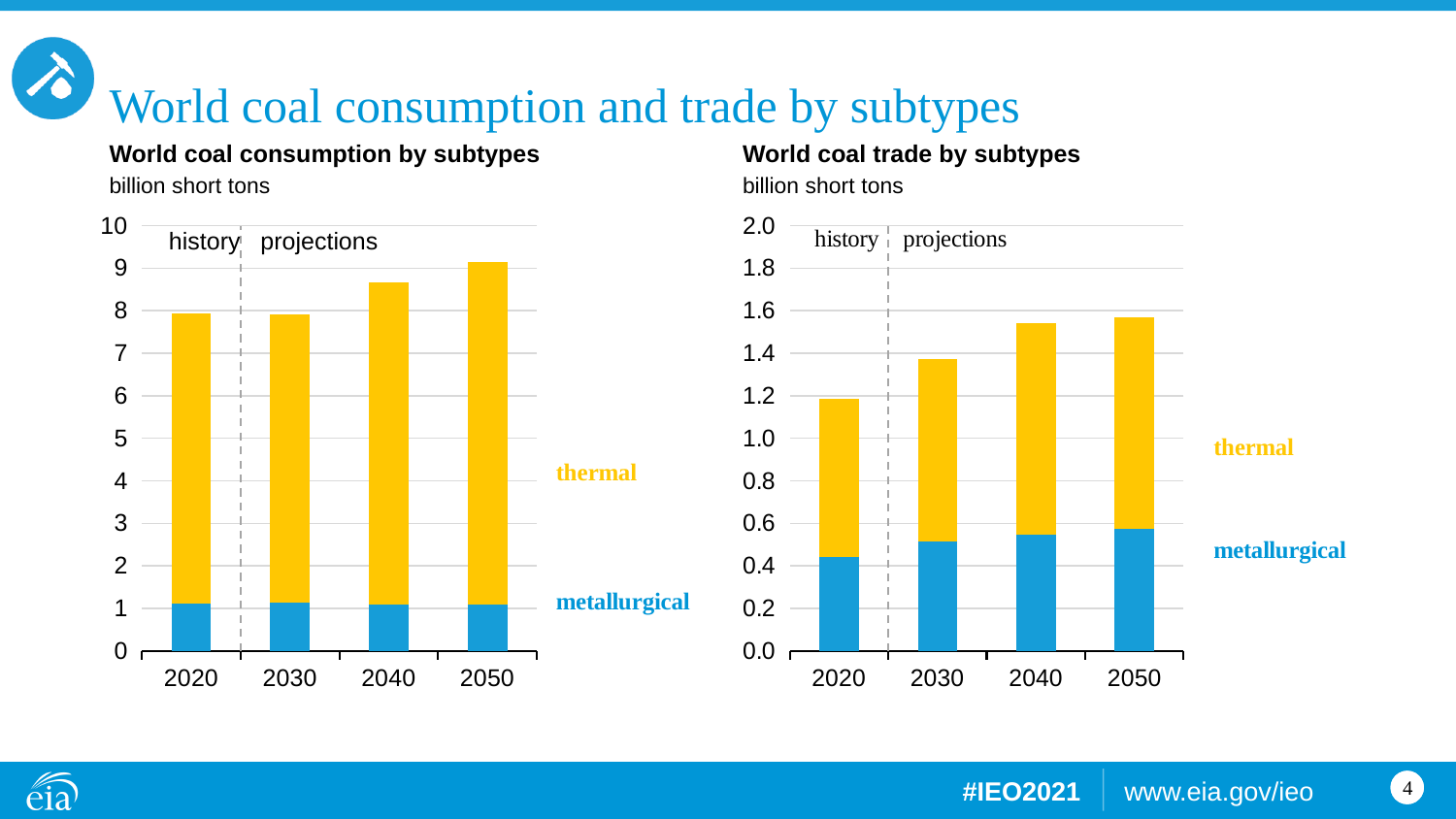
In the 'World coal consumption by subtypes' chart, is the total for 2050 greater or less than 9? greater In the 'World coal trade by subtypes' chart, do the total bars rise or fall from 2020 to 2050? rise What unit is used on the y axis of the 'World coal trade by subtypes' chart? billion short tons In the 'World coal consumption by subtypes' chart, how many series are shown? 2 In the 'World coal trade by subtypes' chart, is the metallurgical value for 2020 greater or less than 0.4? greater In the 'World coal consumption by subtypes' chart, how many years are shown on the x axis? 4 In the 'World coal consumption by subtypes' chart, is the total for 2040 larger than the total for 2030? yes In the 'World coal consumption by subtypes' chart, which year has the highest total bar? 2050 In the 'World coal trade by subtypes' chart, which year has the lowest total bar? 2020 In the 'World coal trade by subtypes' chart, is the total for 2030 greater or less than 1.2? greater What kind of chart is the 'World coal consumption by subtypes' chart? stacked bar chart